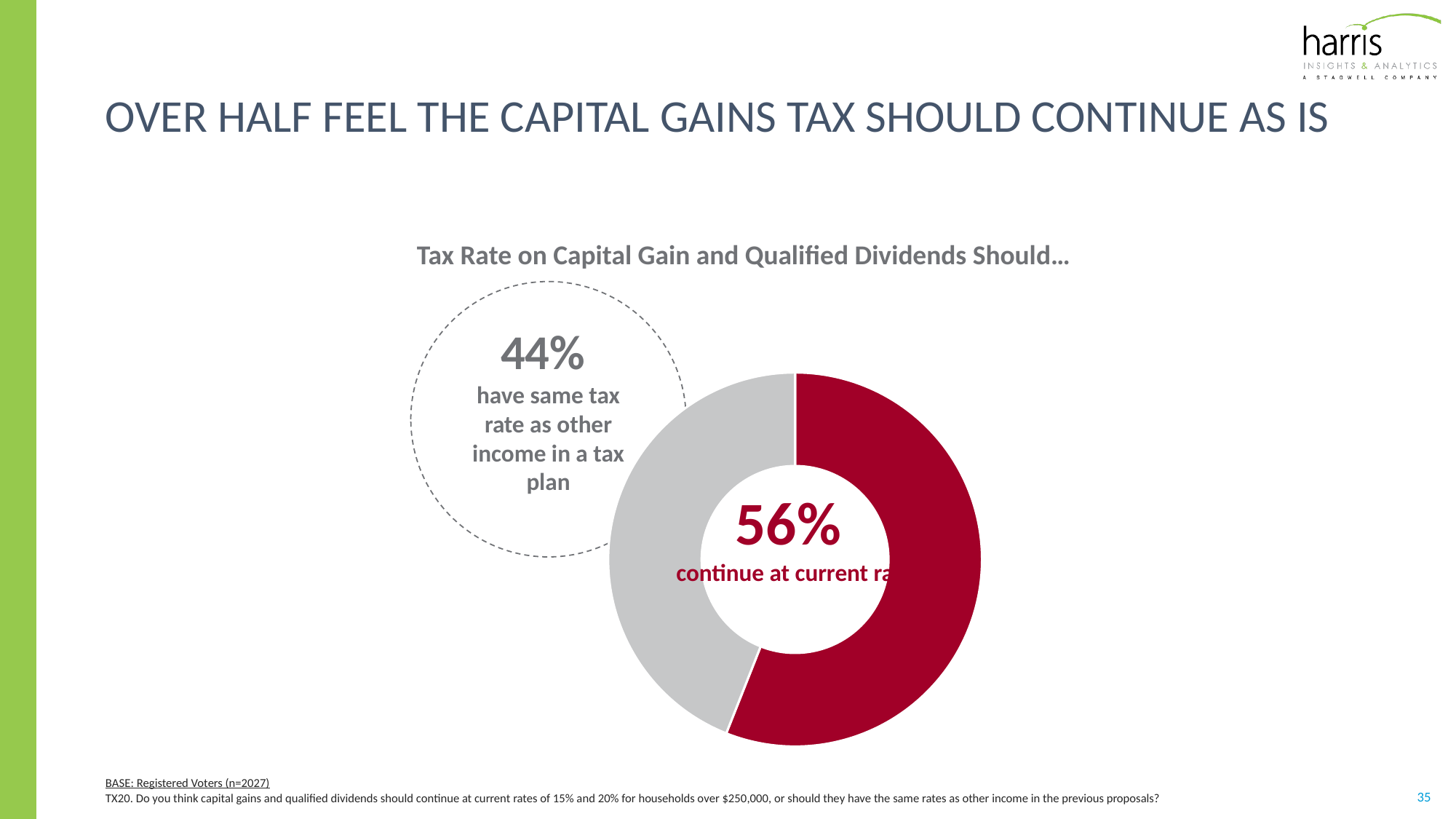
Is the share for 'continue at current rates' larger or smaller than the share for 'have same tax rate as other income'? larger What percentage of respondents feel the tax rate on capital gains and qualified dividends should continue at current rates? 56% Is the share for 'have same tax rate as other income' greater or less than 50%? less Which response has the larger share: continue at current rates or have same tax rate as other income? continue at current rates What kind of chart is used on this slide? Doughnut (pie) chart What percentage of respondents feel capital gains should have the same tax rate as other income in a tax plan? 44% How many response categories are shown in the chart? 2 What is the title of the chart? Tax Rate on Capital Gain and Qualified Dividends Should... Which response has the smaller share of respondents? have same tax rate as other income in a tax plan What is the total of the two percentages shown in the chart? 100% What is the difference in percentage points between those who want to continue at current rates and those who want the same tax rate as other income? 12 What colour is the segment representing 'continue at current rates'? Red